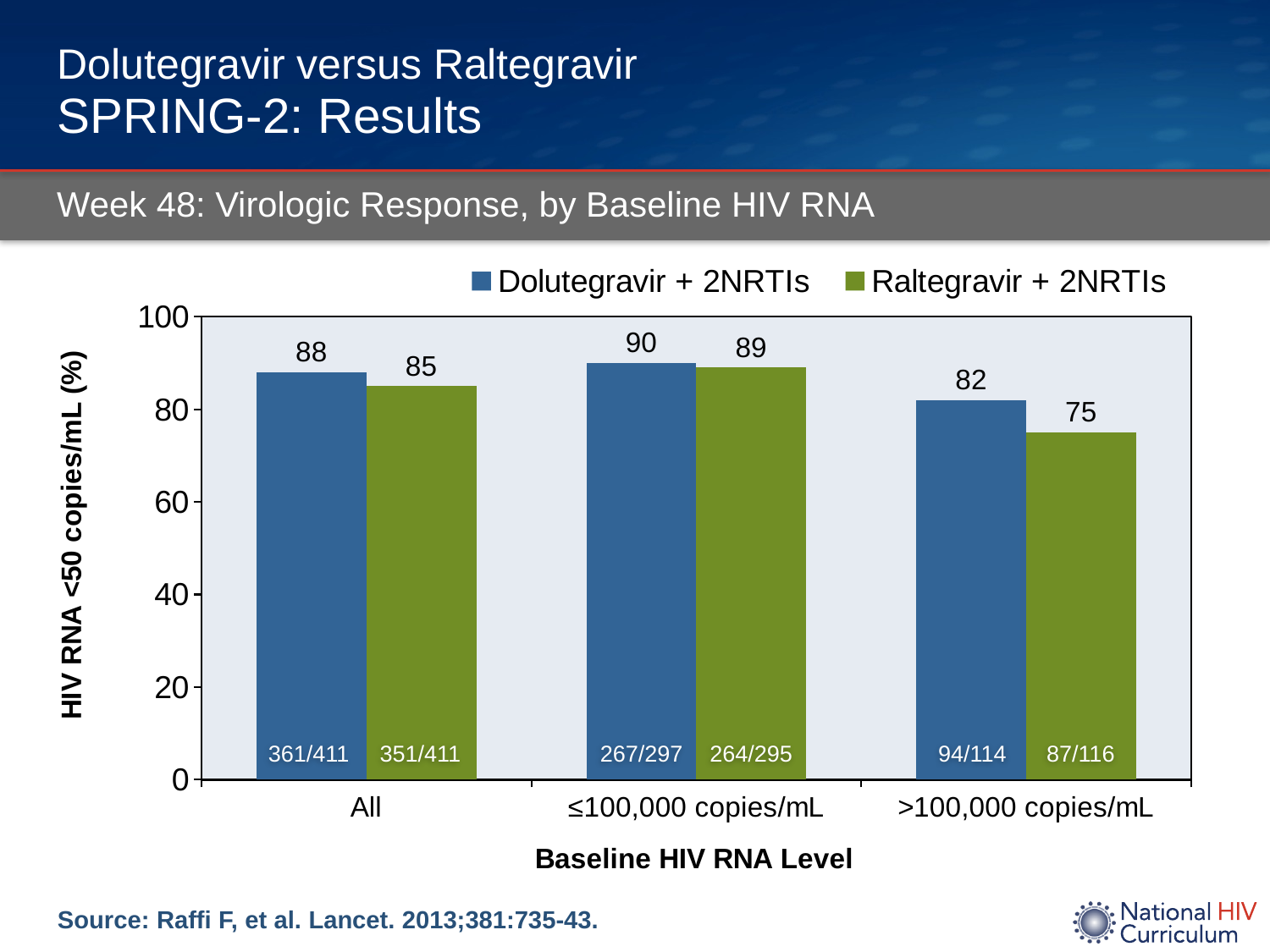
What is the value for Raltegravir + 2NRTIs in the >100,000 copies/mL category? 75 What is the difference between Dolutegravir + 2NRTIs and Raltegravir + 2NRTIs in the >100,000 copies/mL category? 7 What is the value for Dolutegravir + 2NRTIs in the All category? 88 Which series has the larger value in the All category? Dolutegravir + 2NRTIs How many baseline HIV RNA level categories are shown on the x axis? 3 How many series does the legend list? 2 What is the y-axis label of the chart? HIV RNA <50 copies/mL (%) Is the value for Raltegravir + 2NRTIs in the >100,000 copies/mL category greater or less than 80? less What is the value for Raltegravir + 2NRTIs in the ≤100,000 copies/mL category? 89 Which category has the highest value for Dolutegravir + 2NRTIs? ≤100,000 copies/mL What kind of chart is shown on the slide? Bar chart Which category has the lowest value for Raltegravir + 2NRTIs? >100,000 copies/mL